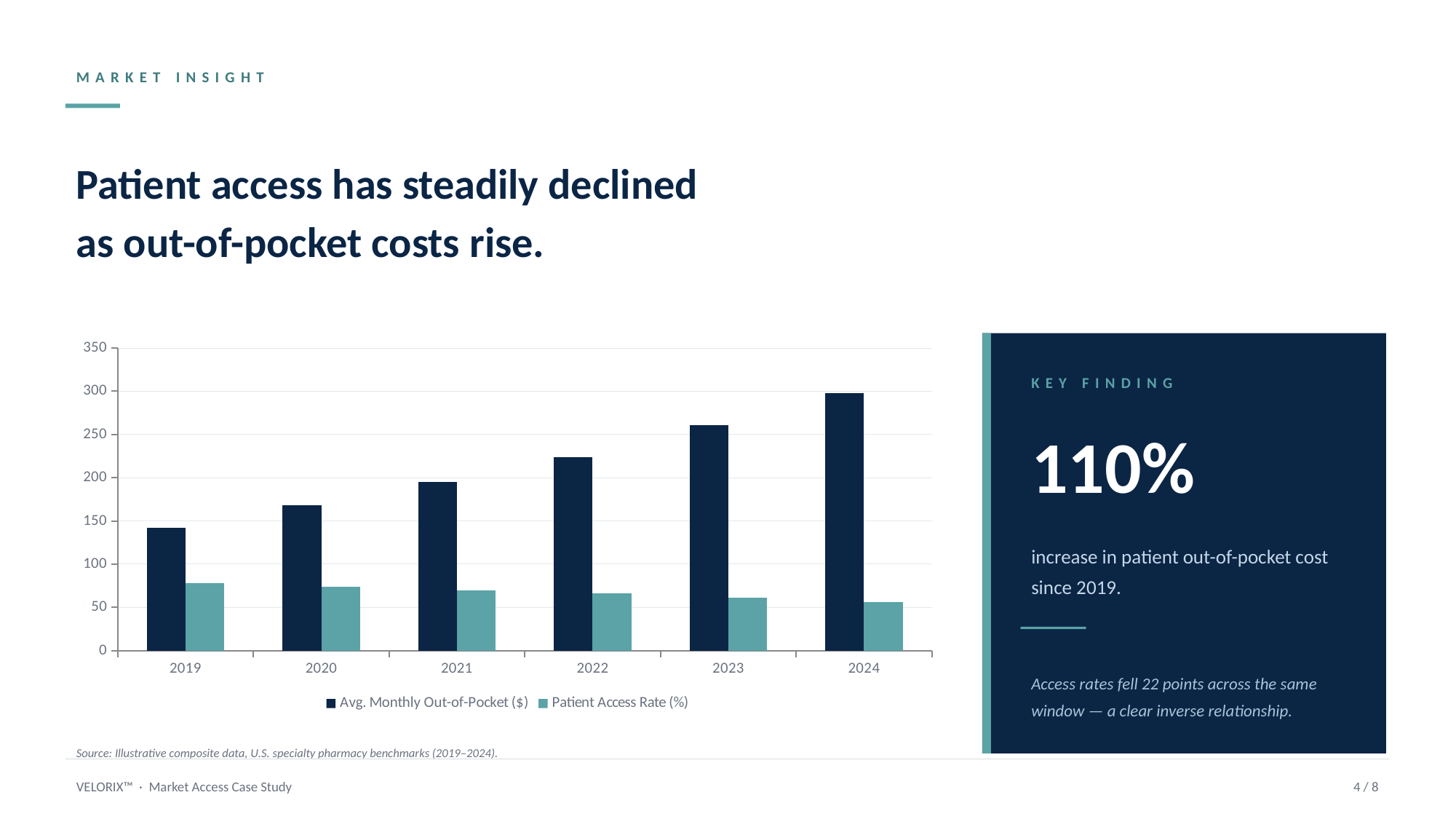
Do the Patient Access Rate (%) values rise or fall from 2019 to 2024? fall What kind of chart is shown on the slide? bar chart Is the Patient Access Rate (%) value for 2019 greater or less than 50? greater Which year has the highest Patient Access Rate (%) value? 2019 Is the Avg. Monthly Out-of-Pocket ($) value for 2019 greater or less than 150? less Which year has the highest Avg. Monthly Out-of-Pocket ($) value? 2024 Which year has the lowest Patient Access Rate (%) value? 2024 Do the Avg. Monthly Out-of-Pocket ($) values rise or fall from 2019 to 2024? rise Which is larger: the Avg. Monthly Out-of-Pocket ($) value for 2023 or for 2020? 2023 Is the Avg. Monthly Out-of-Pocket ($) value for 2024 greater or less than 250? greater How many years are shown on the x axis of the chart? 6 How many series does the chart legend list? 2